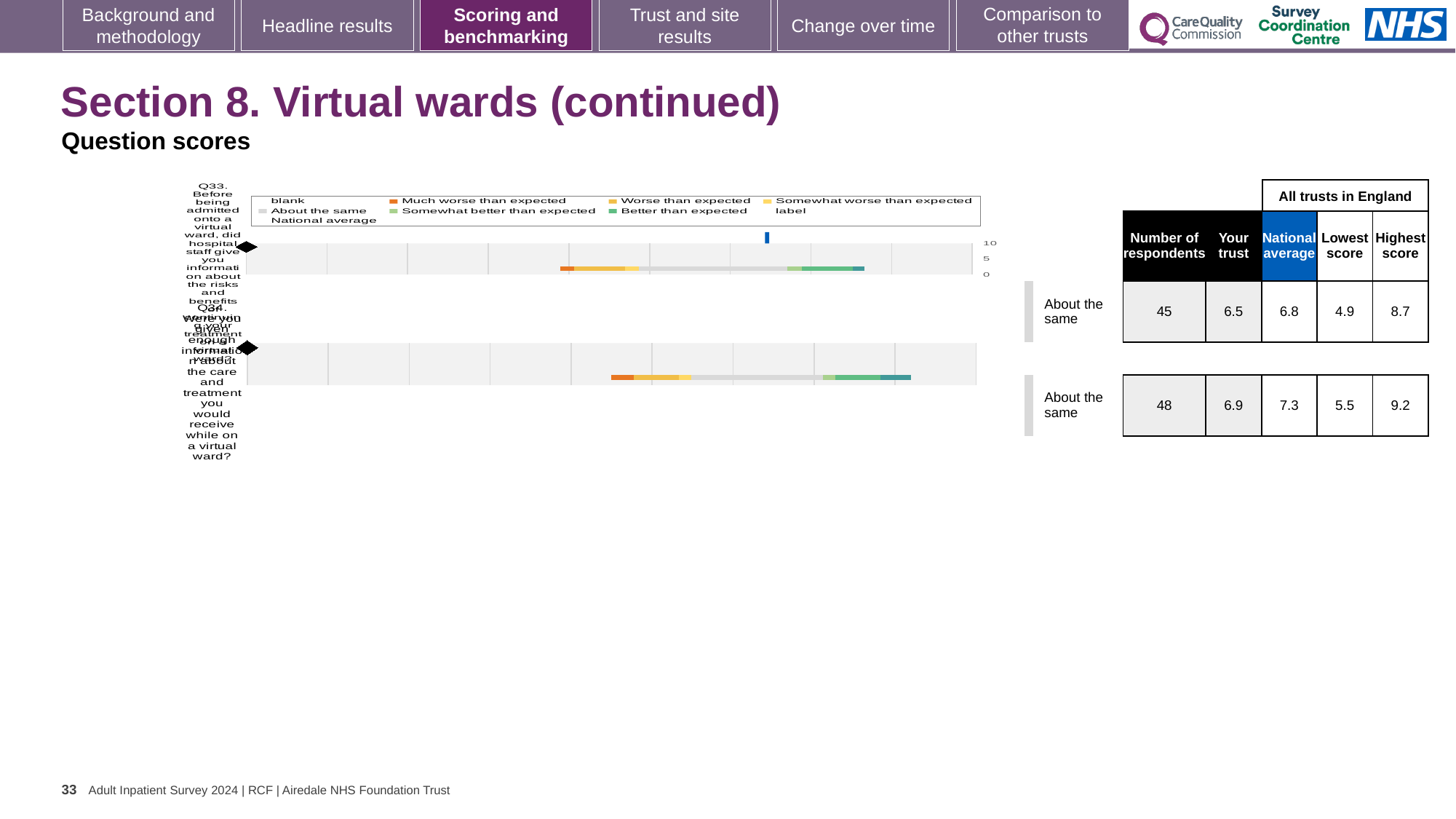
How many survey questions are plotted as bars in the chart? 2 What colour does the legend use for 'Much worse than expected'? orange In the table beside the chart, what is the 'Your trust' score for Q34? 6.9 In the table beside the chart, what is the difference between the highest score and the lowest score for Q34? 3.7 What colour does the legend use for 'Better than expected'? green Which benchmark category is shown next to the bar for Q34? About the same In the table beside the chart, which question has the higher number of respondents? Q34 How many entries does the chart's legend list? 9 In the table beside the chart, how many respondents are listed for Q33? 45 In the table beside the chart, which is larger for Q33: the 'Your trust' score or the 'National average'? National average Which benchmark category is shown next to the bar for Q33? About the same What kind of chart is shown on the slide? bar chart